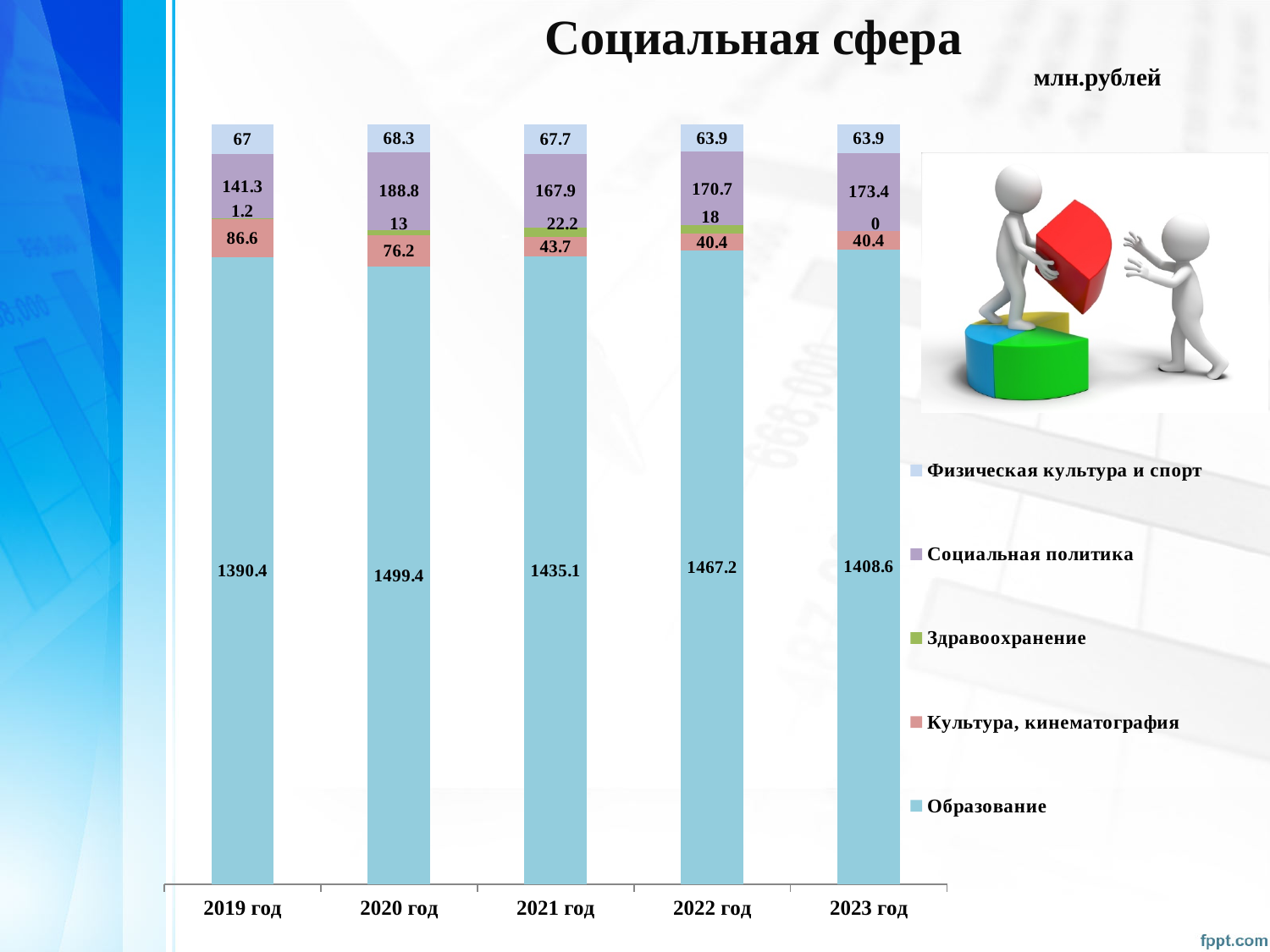
How many series does the legend list? 5 What is the value for Социальная политика in 2021 год? 167.9 What is the value for Культура, кинематография in 2019 год? 86.6 What kind of chart is shown on the slide? Stacked bar chart What is the total of the stacked bar for 2022 год? 1760.2 In which year is the value for Здравоохранение the lowest? 2023 год What is the difference between the Социальная политика values for 2020 год and 2019 год? 47.5 What is the value for Здравоохранение in 2023 год? 0 What is the value for Образование in 2020 год? 1499.4 How many years are shown on the x axis? 5 Which is larger: the Физическая культура и спорт value for 2020 год or for 2021 год? 2020 год In which year is the value for Образование the highest? 2020 год